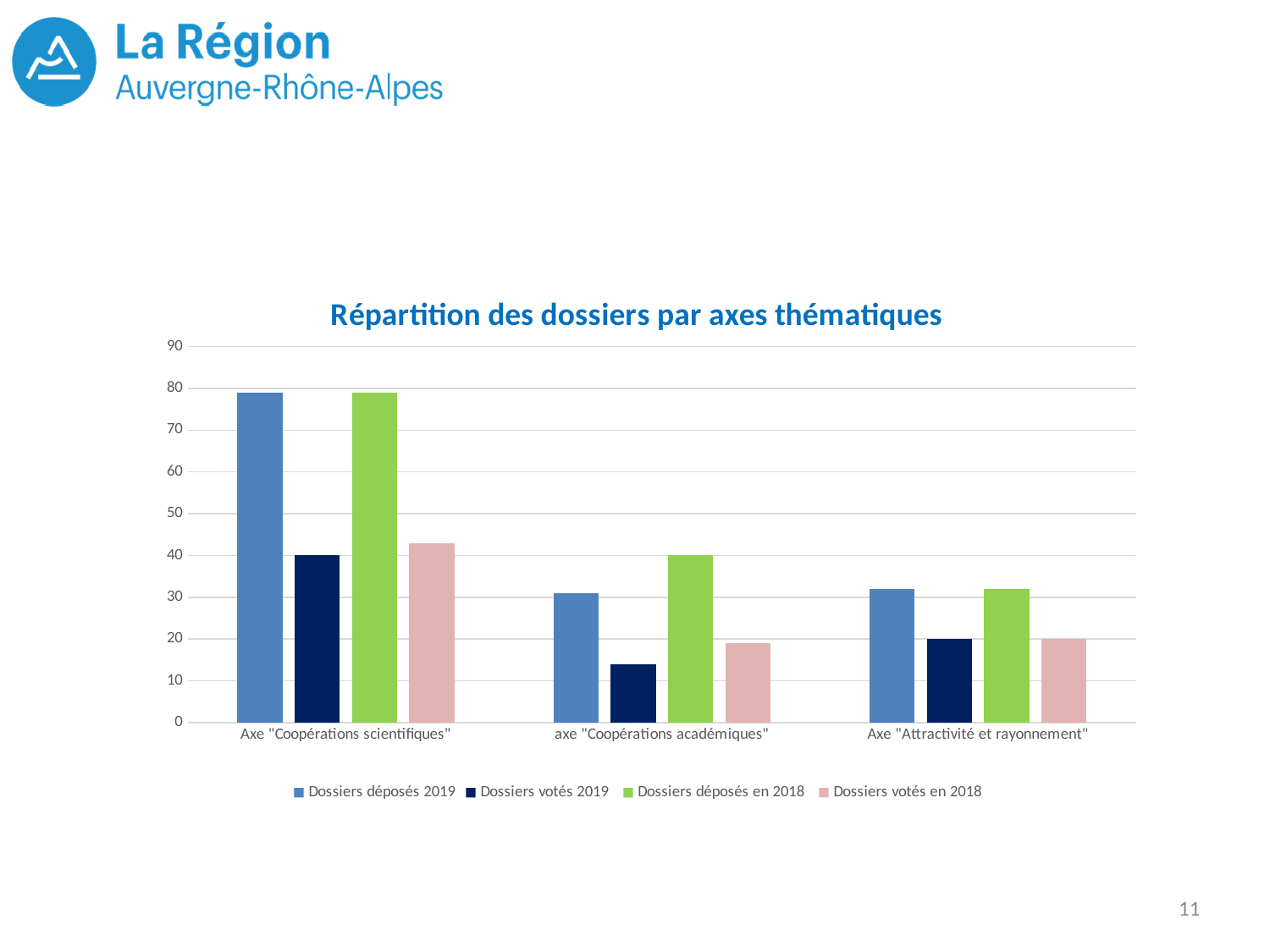
Is the value of Dossiers déposés 2019 for Axe "Coopérations scientifiques" greater or less than 70? greater For which category is the value of Dossiers votés 2019 the highest? Axe "Coopérations scientifiques" For axe "Coopérations académiques", which is larger: Dossiers déposés 2019 or Dossiers déposés en 2018? Dossiers déposés en 2018 Is the value of Dossiers votés en 2018 for axe "Coopérations académiques" greater or less than 30? less Which series is shown in green in the legend? Dossiers déposés en 2018 What kind of chart is shown on the slide? Bar chart Is the value of Dossiers déposés en 2018 for Axe "Coopérations scientifiques" greater or less than 70? greater For which category is the value of Dossiers votés 2019 the lowest? axe "Coopérations académiques" How many categories (axes thématiques) are shown on the x axis? 3 What is the title of the chart? Répartition des dossiers par axes thématiques How many series does the legend list? 4